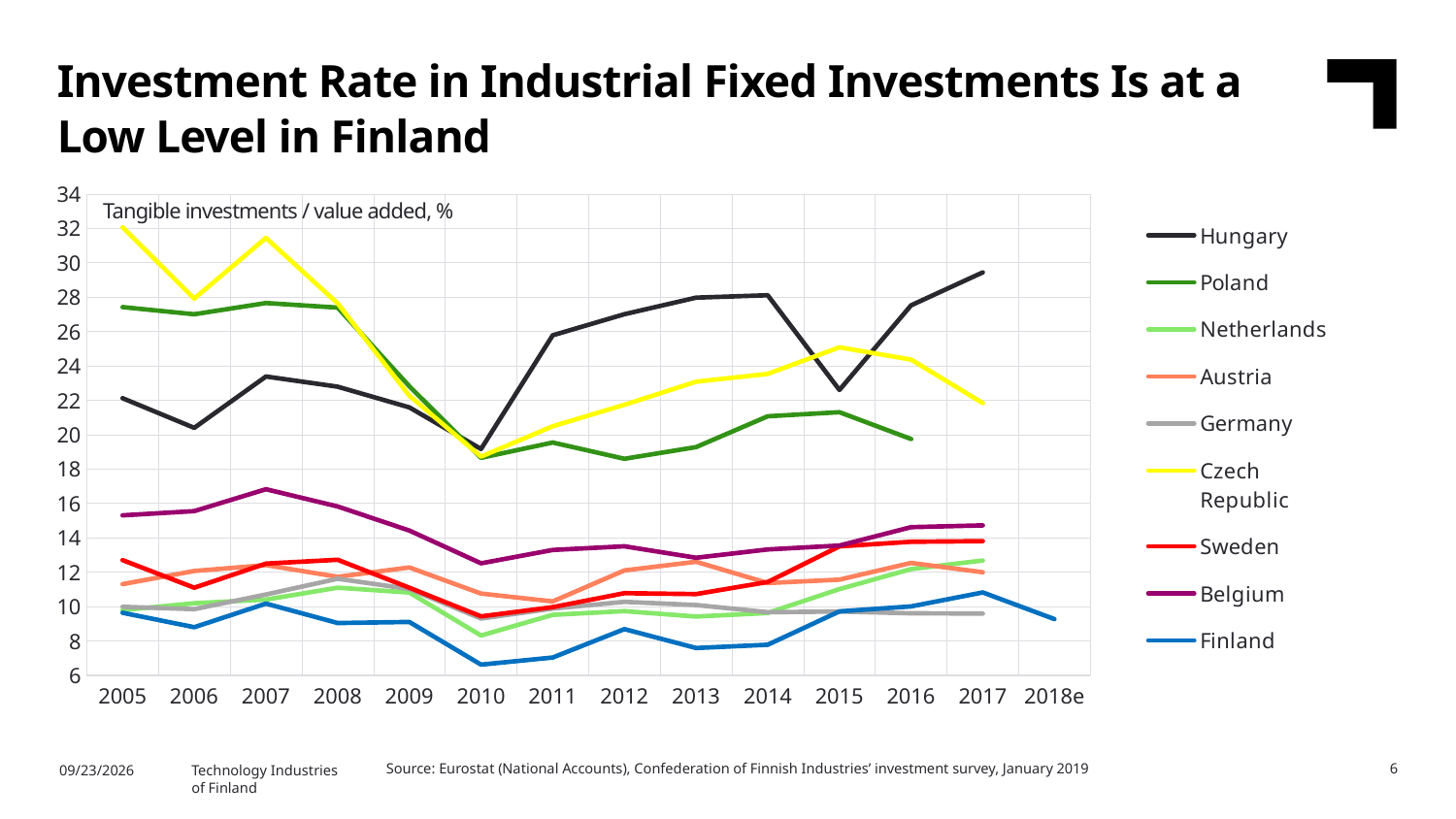
Which is larger in 2017, the value for Hungary or the value for Czech Republic? Hungary Is the value for Finland in 2010 greater or less than 8? less What kind of chart is shown on the slide? line chart Which country has the highest value in 2005? Czech Republic Does the value for Czech Republic rise or fall from 2015 to 2017? fall Is the value for Finland in 2018e greater or less than 10? less How many series does the legend list? 9 Is the value for Czech Republic in 2005 greater or less than 30? greater How many years are shown on the x axis? 14 Which country has the lowest value in 2010? Finland What is the subtitle text shown inside the chart area? Tangible investments / value added, %